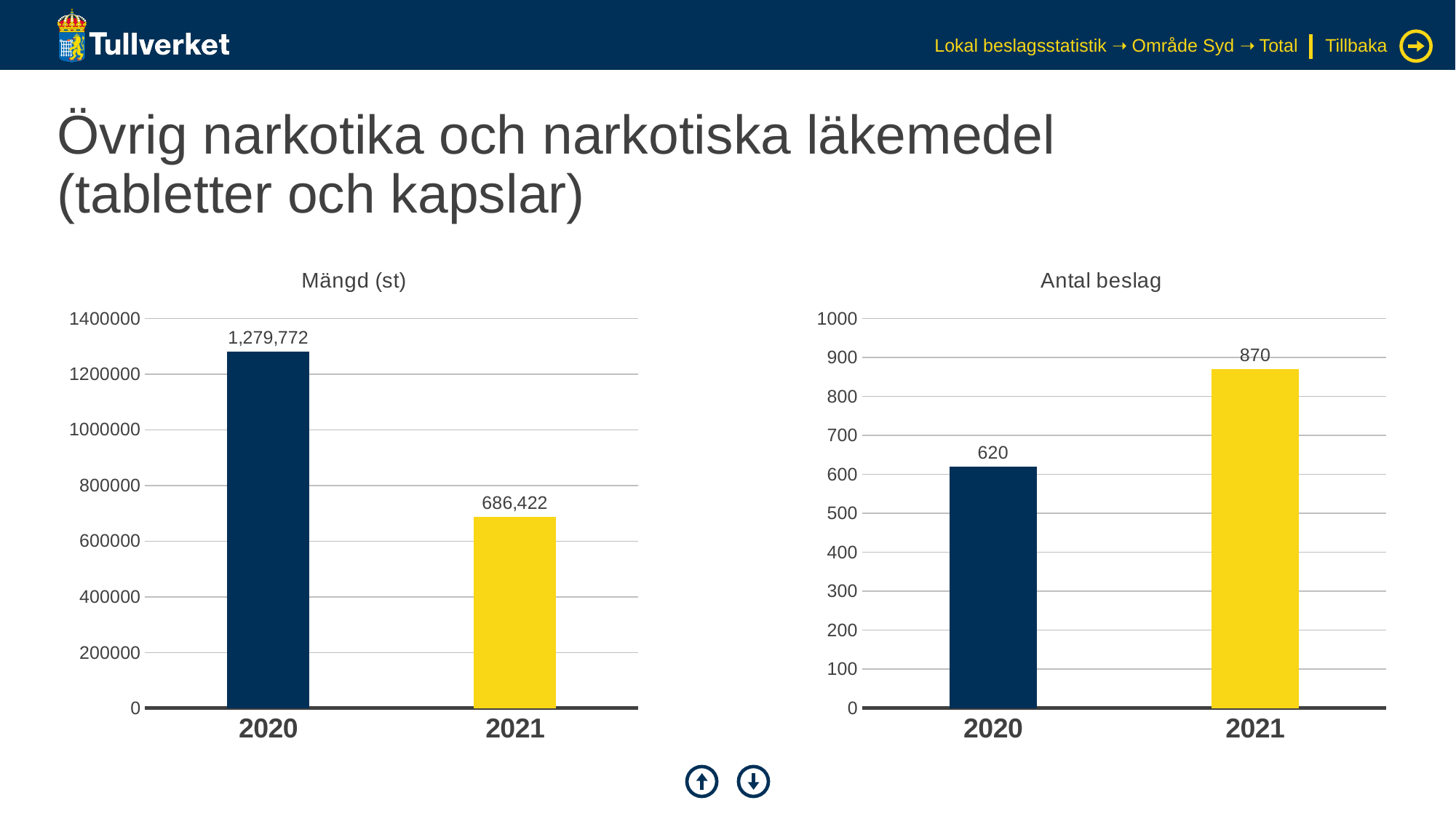
In the 'Mängd (st)' chart, which year has the highest value? 2020 How many categories are shown on the x axis of the 'Mängd (st)' chart? 2 What kind of chart is the 'Antal beslag' chart? bar chart In the 'Mängd (st)' chart, what is the value for 2020? 1,279,772 In the 'Antal beslag' chart, what is the value for 2020? 620 In the 'Mängd (st)' chart, what is the value for 2021? 686,422 In the 'Mängd (st)' chart, what is the difference between the values for 2020 and 2021? 593,350 In the 'Antal beslag' chart, is the value for 2021 greater or less than 800? greater In the 'Antal beslag' chart, what is the value for 2021? 870 In the 'Antal beslag' chart, what is the difference between the values for 2021 and 2020? 250 In the 'Mängd (st)' chart, do the values rise or fall from 2020 to 2021? fall In the 'Antal beslag' chart, which year has the lowest value? 2020